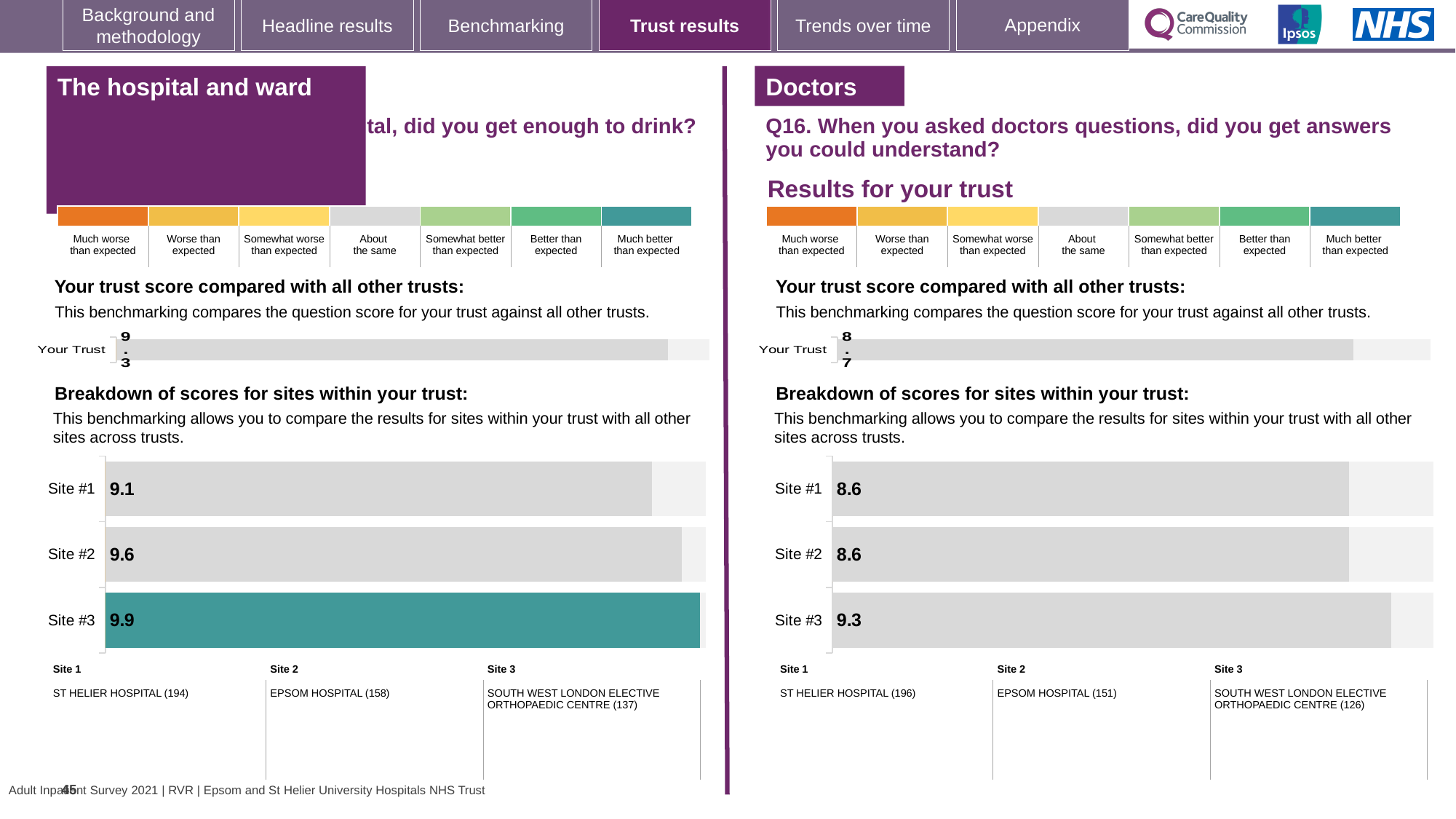
In the right-hand (Doctors, Q16) site breakdown chart, what is the score for Site #3? 9.3 In the left-hand site breakdown chart, which site has the lowest score? Site #1 How many sites are shown in the right-hand (Doctors, Q16) site breakdown chart? 3 What type of chart is the left-hand 'Breakdown of scores for sites within your trust' chart? Bar chart In the left-hand 'Breakdown of scores for sites within your trust' chart, what is the score for Site #3? 9.9 In the right-hand (Doctors, Q16) site breakdown chart, what is the difference between the scores for Site #3 and Site #1? 0.7 In the left-hand site breakdown chart, which has the larger score, Site #2 or Site #1? Site #2 In the right-hand (Doctors, Q16) site breakdown chart, what is the score for Site #2? 8.6 In the right-hand (Doctors, Q16) site breakdown chart, which site has the highest score? Site #3 In the left-hand site breakdown chart, which site has the highest score? Site #3 In the left-hand site breakdown chart, what is the difference between the scores for Site #3 and Site #1? 0.8 In the left-hand site breakdown chart, what is the score for Site #1? 9.1